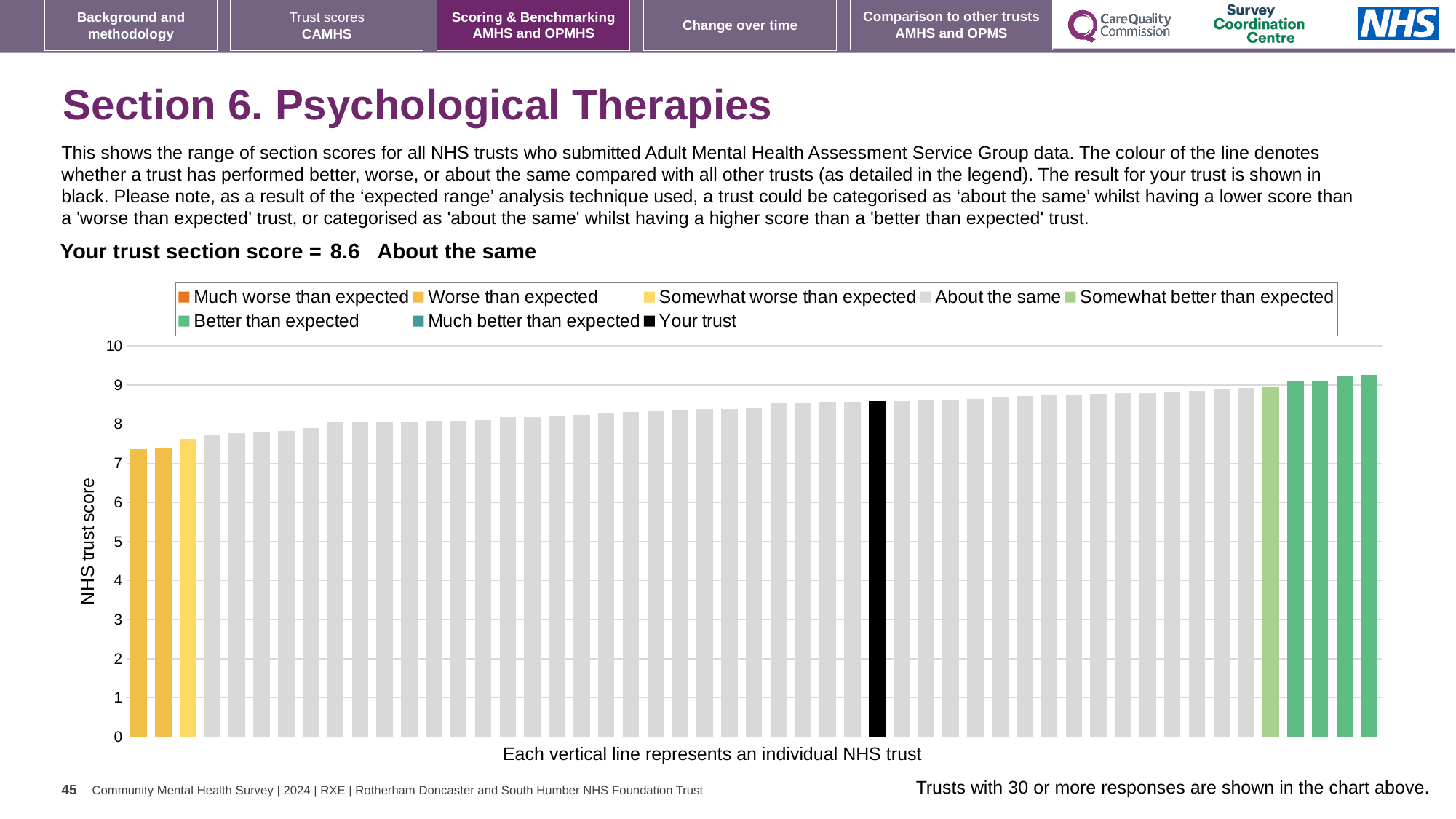
Is the value of the leftmost bar greater or less than 8? less Which is larger, the leftmost bar or the rightmost bar? the rightmost bar Which legend category does the lowest bar belong to? Worse than expected How many entries does the chart legend list? 8 Do the bar values rise or fall from left to right along the x axis? rise What is the section score for your trust? 8.6 Which legend category does the highest bar belong to? Better than expected Is the value for your trust (the black bar) greater or less than 8? greater What is the label on the y axis? NHS trust score Is the value of the rightmost bar greater or less than 9? greater What colour is the bar for your trust? black What kind of chart is shown on the slide? bar chart